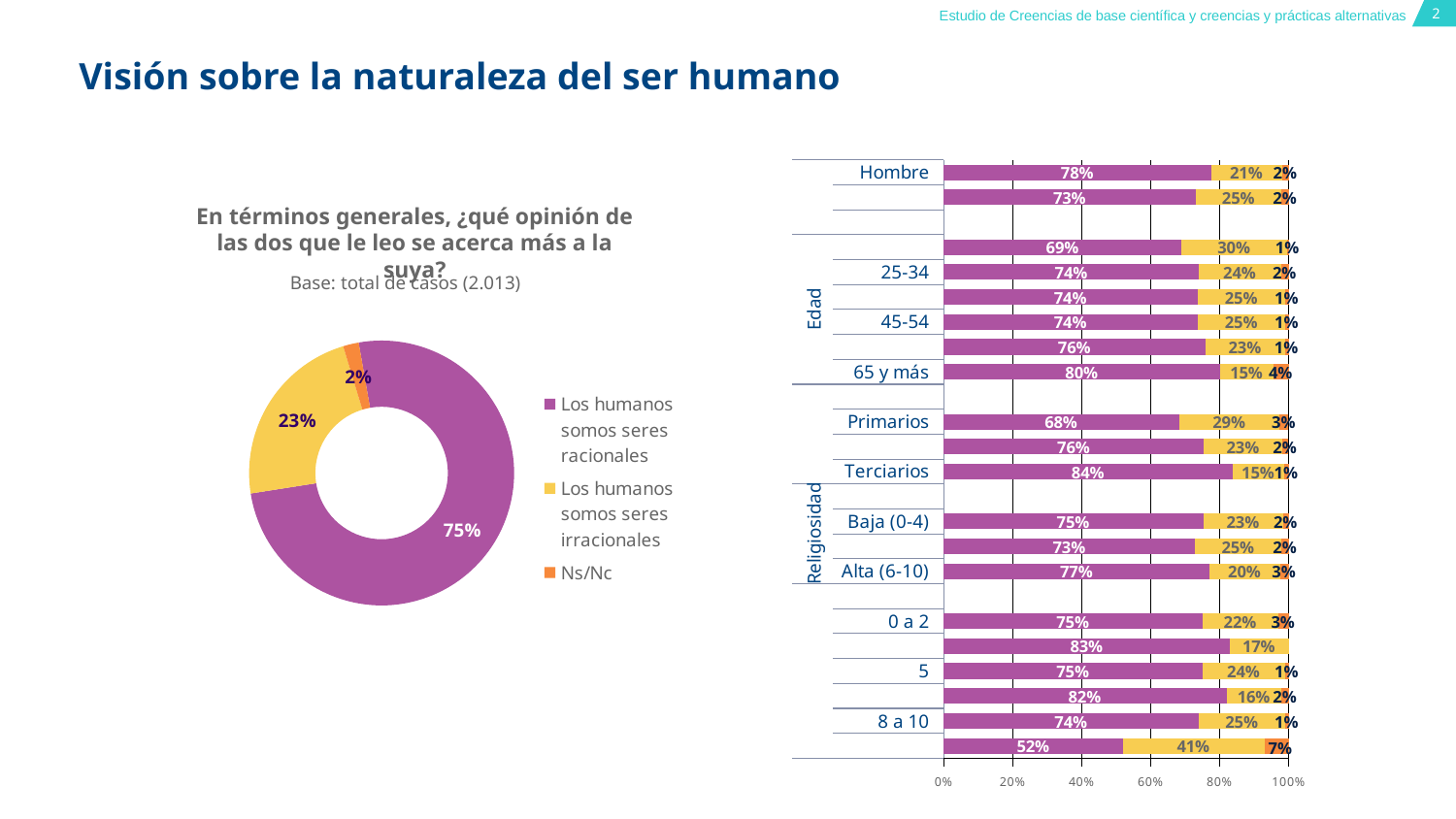
In the bar chart on the right, which category has the highest value for the first (purple) segment? Terciarios In the bar chart on the right, what is the value of the first (purple) segment for 'Hombre'? 78% In the donut chart on the left, what percentage corresponds to 'Los humanos somos seres racionales'? 75% In the bar chart on the right, which has a larger first (purple) segment, 'Terciarios' or 'Primarios'? Terciarios In the bar chart on the right, what is the value of the middle (yellow) segment for 'Alta (6-10)'? 20% What kind of chart is the one on the left of the slide? Pie (donut) chart In the donut chart on the left, what is the difference in percentage points between 'racionales' and 'irracionales'? 52 percentage points What kind of chart is the one on the right of the slide? Bar chart In the bar chart on the right, what is the value of the first (purple) segment for '65 y más'? 80% In the donut chart on the left, what percentage corresponds to 'Ns/Nc'? 2% In the bar chart on the right, what is the difference in percentage points between the first (purple) segments of 'Terciarios' and 'Primarios'? 16 percentage points How many entries does the legend of the donut chart on the left list? 3